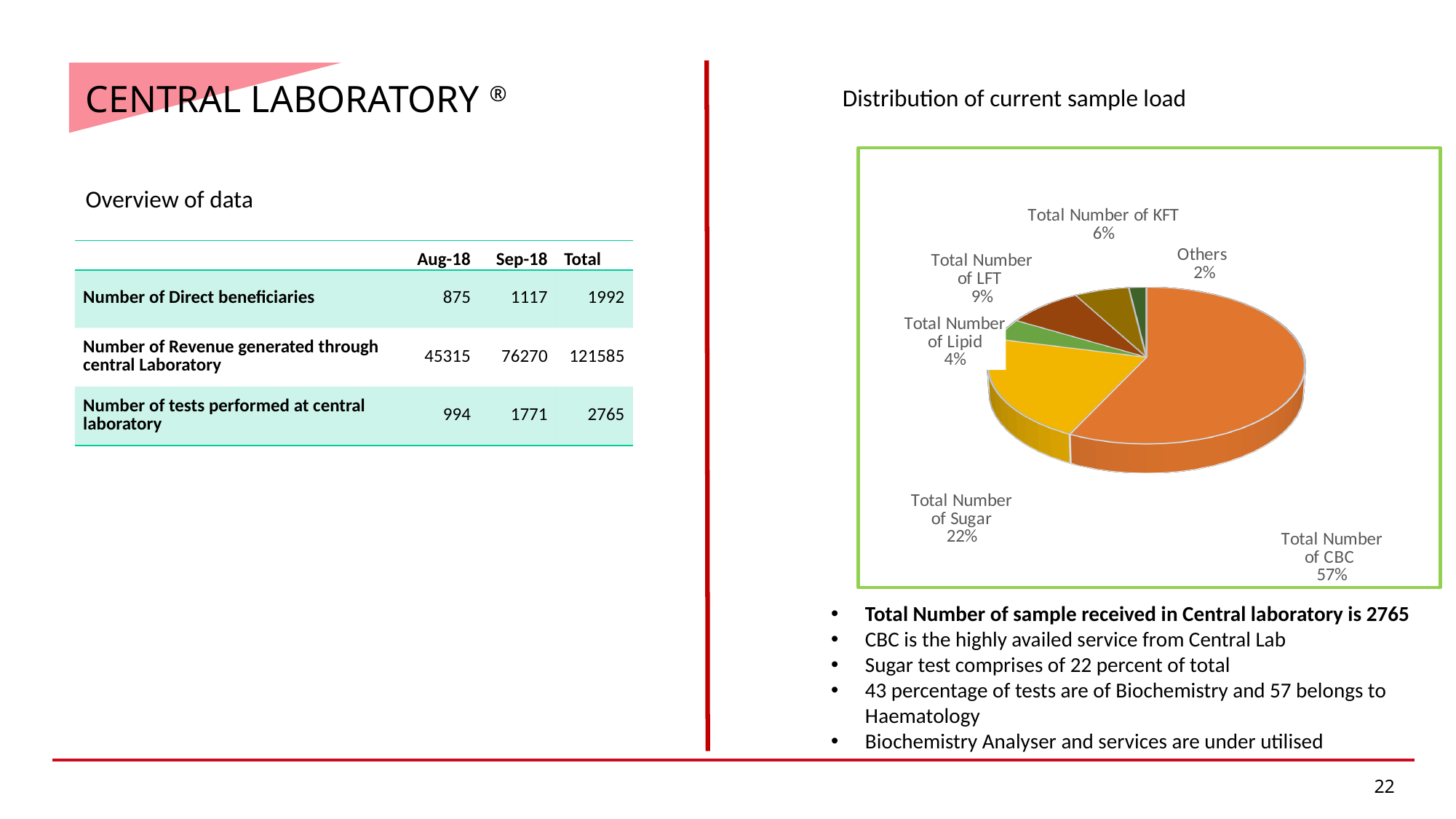
What is the difference between the shares of Total Number of CBC and Total Number of Sugar? 35% Which is larger, the share for Total Number of LFT or Total Number of KFT? Total Number of LFT Which slice of the pie is the smallest? Others What is the value shown for Others? 2% What is the value shown for Total Number of LFT? 9% What is the value shown for Total Number of Lipid? 4% What share of the pie does Total Number of CBC represent? 57% Which slice of the pie is the largest? Total Number of CBC What share of the pie does Total Number of Sugar represent? 22% What is the value shown for Total Number of KFT? 6% How many slices does the pie chart have? 6 What kind of chart is shown on the slide? pie chart